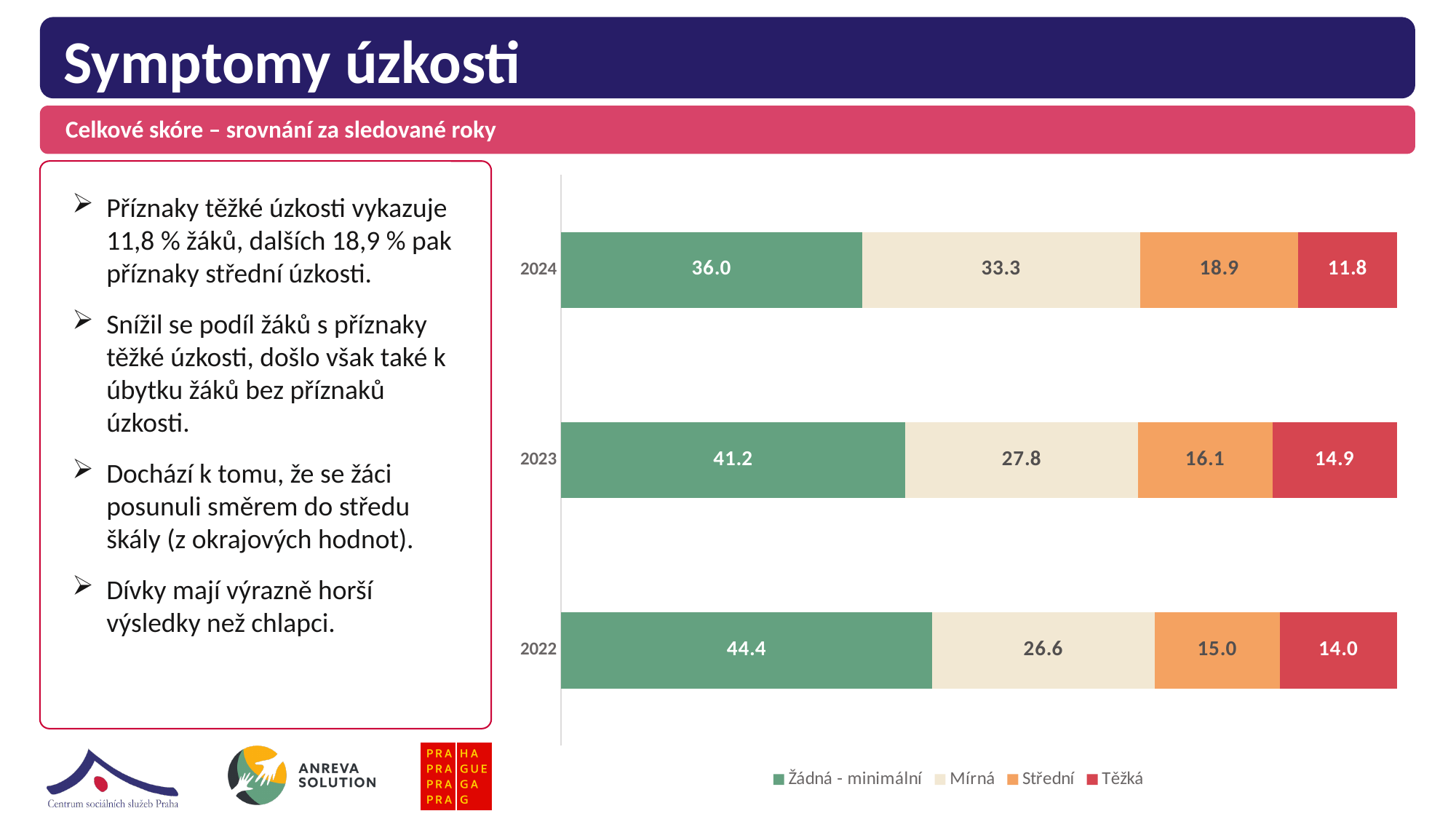
Which year has the highest value for Žádná - minimální? 2022 What type of chart is shown on the slide? stacked bar chart How many years (categories) are shown on the chart? 3 What is the difference between the Žádná - minimální values for 2022 and 2024? 8.4 Which year has the lowest value for Těžká? 2024 Which is larger: the Mírná value in 2024 or the Mírná value in 2022? 2024 What is the value for Mírná in 2023? 27.8 What is the value for Žádná - minimální in 2022? 44.4 How many series does the legend list? 4 What is the value for Střední in 2024? 18.9 What is the total of the stacked bar for 2023? 100.0 What is the value for Těžká in 2024? 11.8